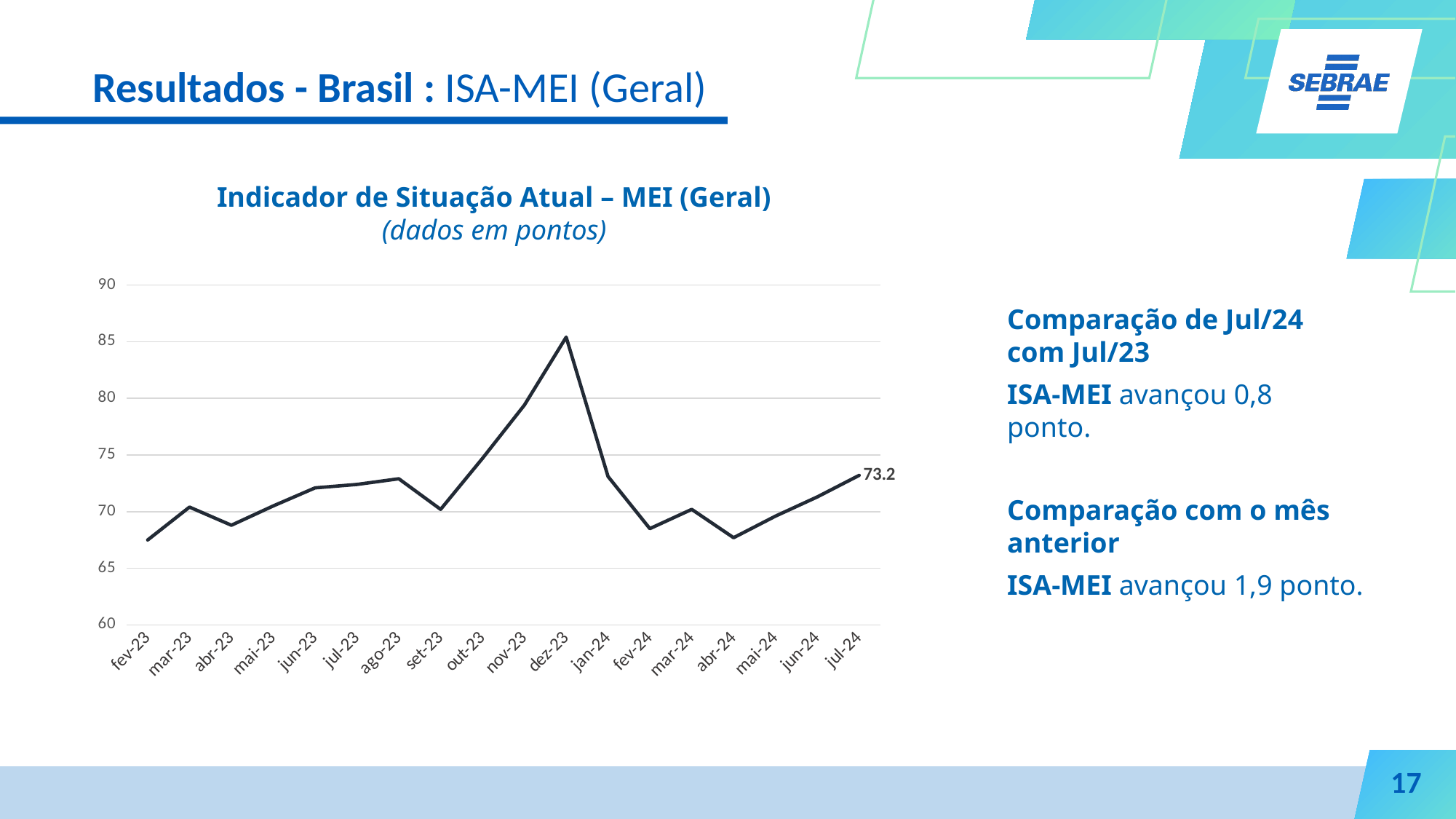
How many data points are plotted in the chart? 18 What type of chart is shown on the slide? line chart What is the title of the chart? Indicador de Situação Atual – MEI (Geral) Is the value for set-23 greater or less than 75? less What is the value for jul-24 in the chart? 73.2 Is the value for dez-23 greater or less than 80? greater Which is larger, the value for dez-23 or the value for jul-24? dez-23 Is the value for fev-23 greater or less than 70? less Which month has the highest value in the chart? dez-23 Do the values rise or fall from dez-23 to jan-24? fall Do the values rise or fall from abr-24 to jul-24? rise